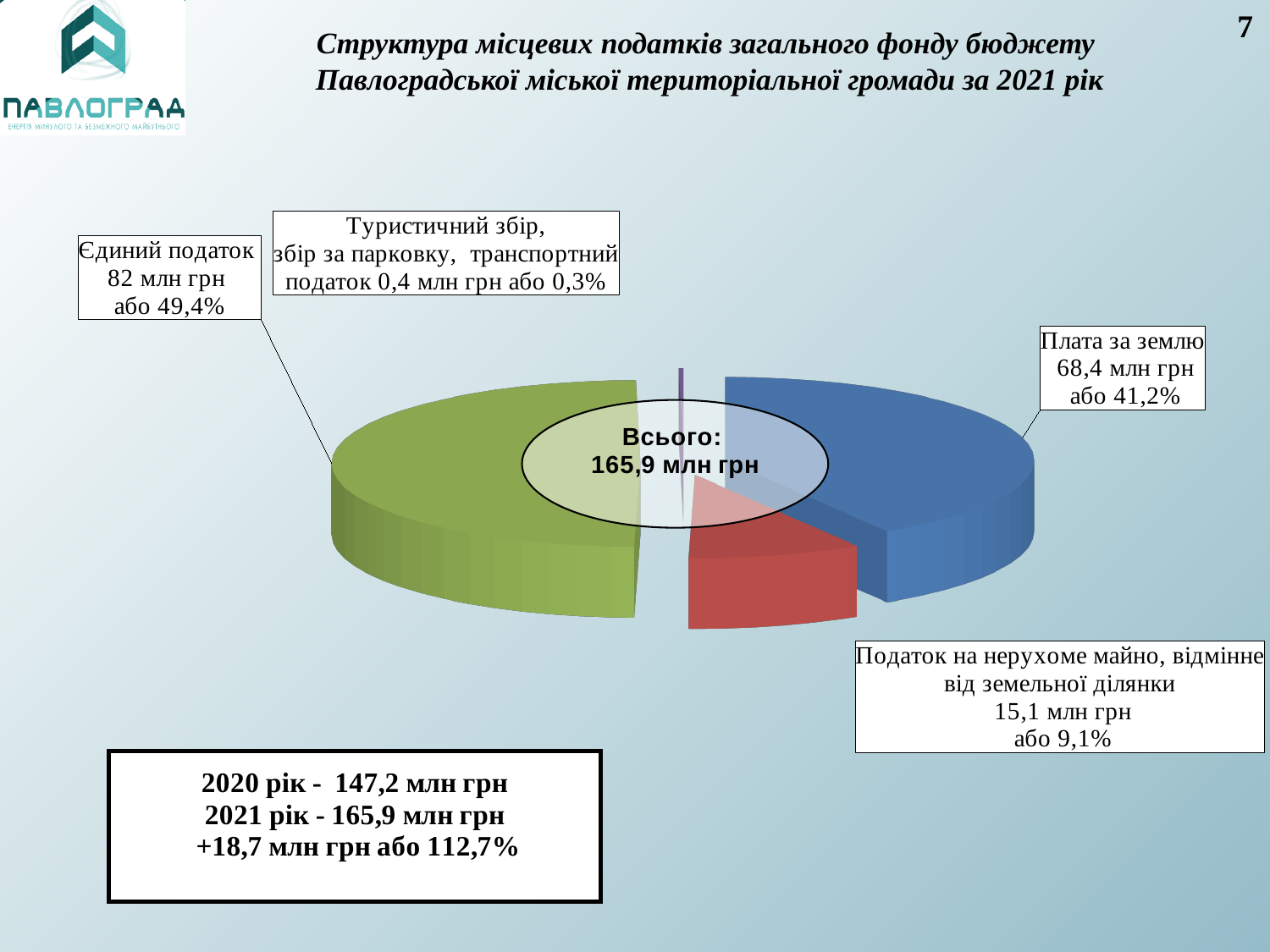
What share of the pie does Плата за землю represent? 41,2% Which is larger, Плата за землю or Податок на нерухоме майно? Плата за землю Which category has the largest slice of the pie? Єдиний податок What is the value for Єдиний податок? 82 млн грн What total is shown in the centre of the pie chart? 165,9 млн грн What is the difference in млн грн between Єдиний податок and Плата за землю? 13,6 млн грн What kind of chart is shown on the slide? Pie chart What is the value for Податок на нерухоме майно, відмінне від земельної ділянки? 15,1 млн грн What share of the pie do Туристичний збір, збір за парковку and транспортний податок together represent? 0,3% Which category has the smallest slice of the pie? Туристичний збір, збір за парковку, транспортний податок How many slices does the pie chart have? 4 What colour is the slice for Плата за землю? Blue